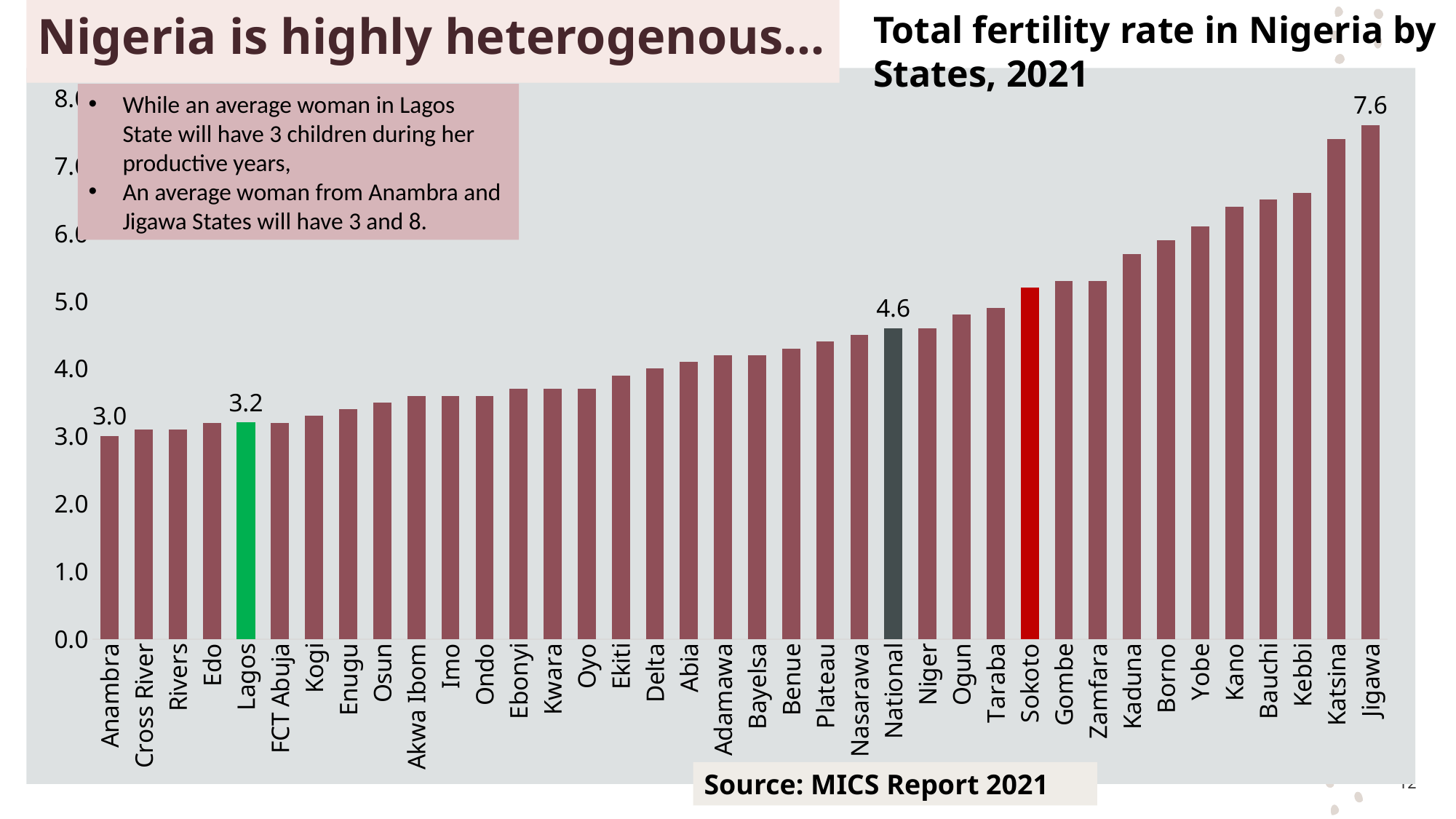
Do the values generally rise or fall moving from left to right along the x axis? rise What colour is the bar for Lagos? green What is the difference between the total fertility rates of Jigawa and Anambra? 4.6 What is the total fertility rate shown for Lagos? 3.2 What is the value shown for the National bar? 4.6 Which has a higher total fertility rate, Katsina or Kano? Katsina Which state has the highest total fertility rate in the chart? Jigawa Which state has the lowest total fertility rate in the chart? Anambra What is the total fertility rate shown for Jigawa? 7.6 What is the total fertility rate shown for Anambra? 3.0 How much higher is the National value than the value for Lagos? 1.4 Is the value for Kaduna greater or less than 5.0? greater